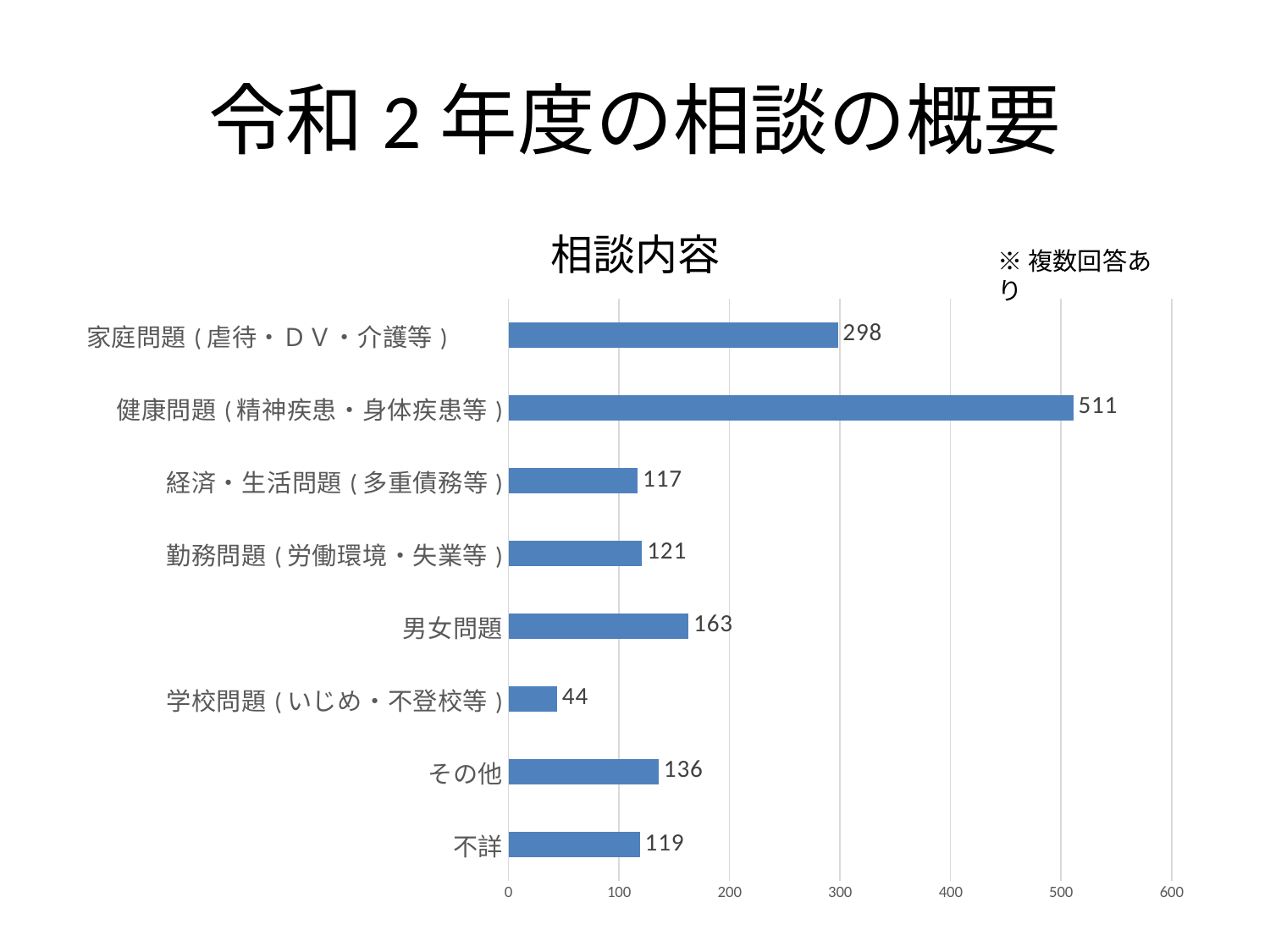
What is the value for 学校問題(いじめ・不登校等)? 44 How many categories are shown in the chart? 8 Which category has the lowest value? 学校問題(いじめ・不登校等) What kind of chart is shown on the slide? bar chart Is the value for 勤務問題(労働環境・失業等) greater or less than 100? greater What is the value for 男女問題? 163 Which category has the highest value? 健康問題(精神疾患・身体疾患等) What is the title of the chart? 相談内容 What is the value for 家庭問題(虐待・DV・介護等)? 298 What is the difference between the values for 健康問題(精神疾患・身体疾患等) and 家庭問題(虐待・DV・介護等)? 213 What is the value for 健康問題(精神疾患・身体疾患等)? 511 Which is larger, the value for その他 or the value for 不詳? その他